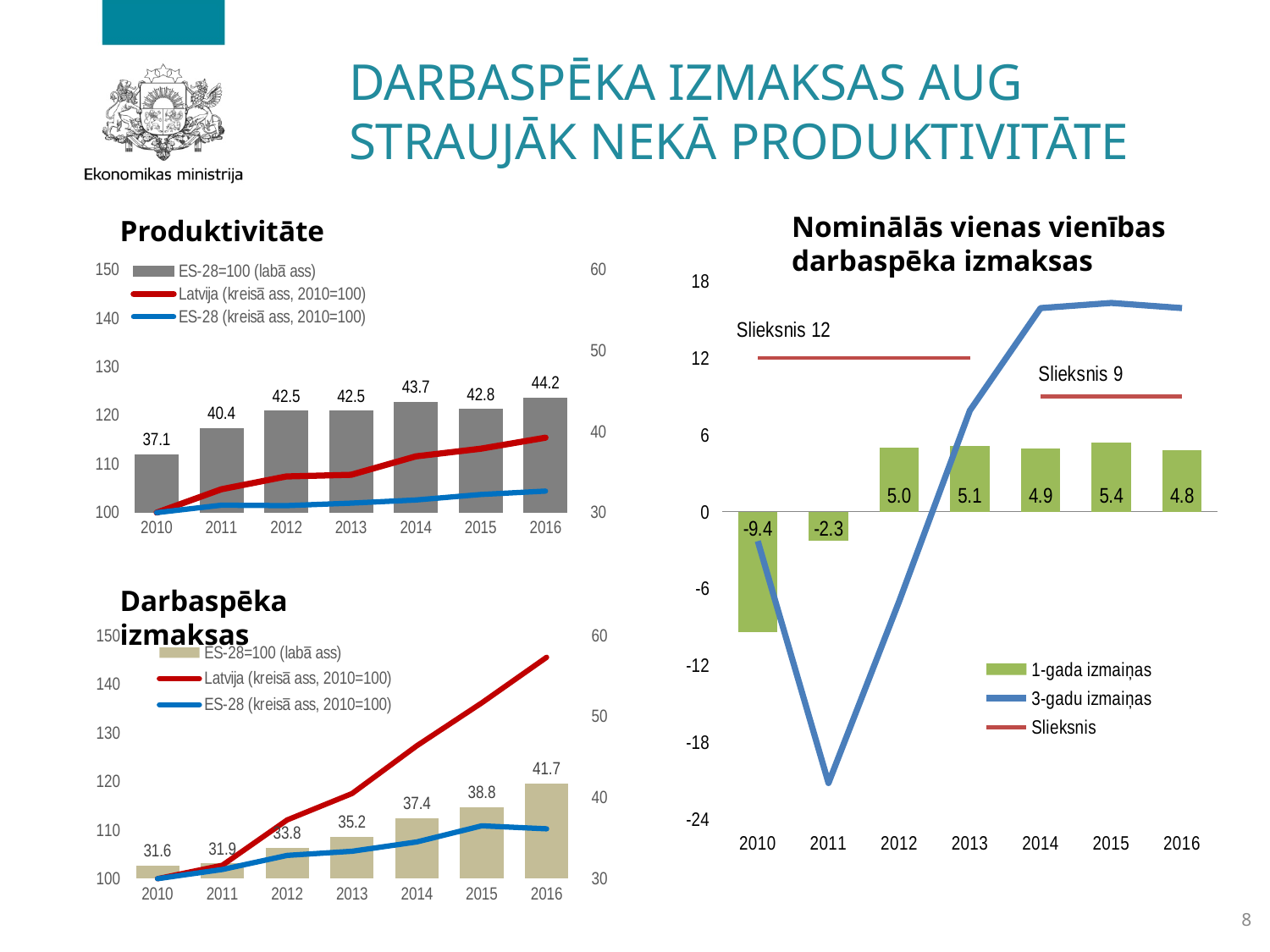
In the Produktivitāte chart, what is the difference between the ES-28=100 bar values for 2016 and 2010? 7.1 In the Nominālās vienas vienības darbaspēka izmaksas chart, which year has the lowest 1-gada izmaiņas value? 2010 In the Darbaspēka izmaksas chart, is the ES-28=100 bar for 2013 larger or smaller than the bar for 2014? smaller In the Produktivitāte chart, what is the value of the ES-28=100 bar for 2010? 37.1 In the Darbaspēka izmaksas chart, what is the value of the ES-28=100 bar for 2015? 38.8 In the Nominālās vienas vienības darbaspēka izmaksas chart, how many years are shown on the x axis? 7 In the Nominālās vienas vienības darbaspēka izmaksas chart, is the 3-gadu izmaiņas value for 2011 greater or less than -18? less In the Produktivitāte chart, which year has the lowest ES-28=100 bar? 2010 In the Nominālās vienas vienības darbaspēka izmaksas chart, what is the 1-gada izmaiņas value for 2011? -2.3 In the Darbaspēka izmaksas chart, how many series does the legend list? 3 In the Darbaspēka izmaksas chart, which year has the highest ES-28=100 bar? 2016 In the Produktivitāte chart, what is the value of the ES-28=100 bar for 2016? 44.2